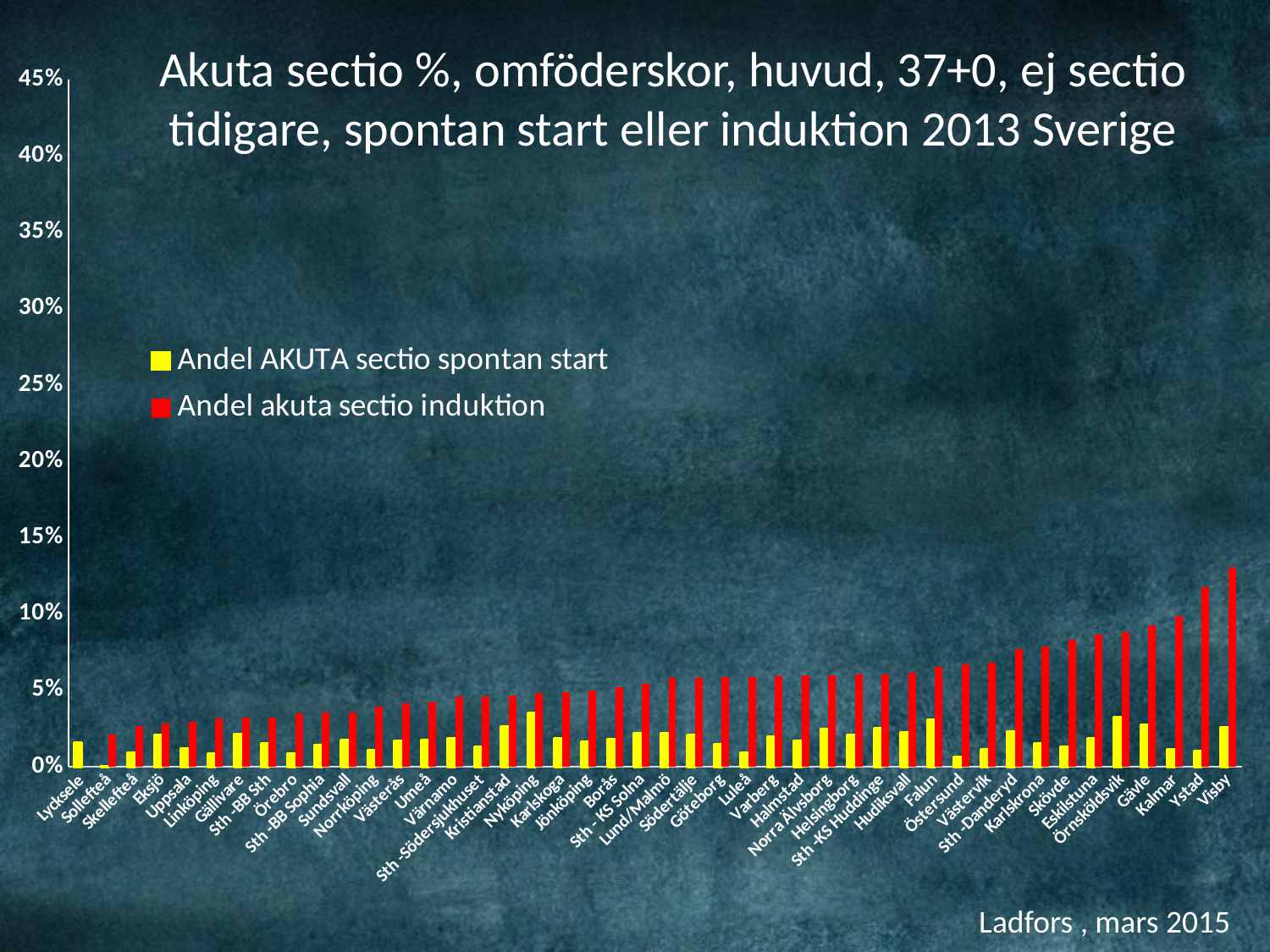
Which hospital has the highest value for Andel akuta sectio induktion? Visby How many hospitals (categories) are shown along the x axis? 44 Is the value for Andel akuta sectio induktion at Ystad greater or less than 10%? greater Which colour represents Andel AKUTA sectio spontan start in the legend? yellow Is the value for Andel akuta sectio induktion at Visby greater or less than 10%? greater Do the values for Andel akuta sectio induktion generally rise or fall from left to right along the x axis? rise Is the value for Andel akuta sectio induktion at Sollefteå greater or less than 5%? less How many series does the legend list? 2 Which is larger for Andel akuta sectio induktion: Visby or Lycksele? Visby What kind of chart is shown on the slide? bar chart Which is larger at Visby: Andel AKUTA sectio spontan start or Andel akuta sectio induktion? Andel akuta sectio induktion